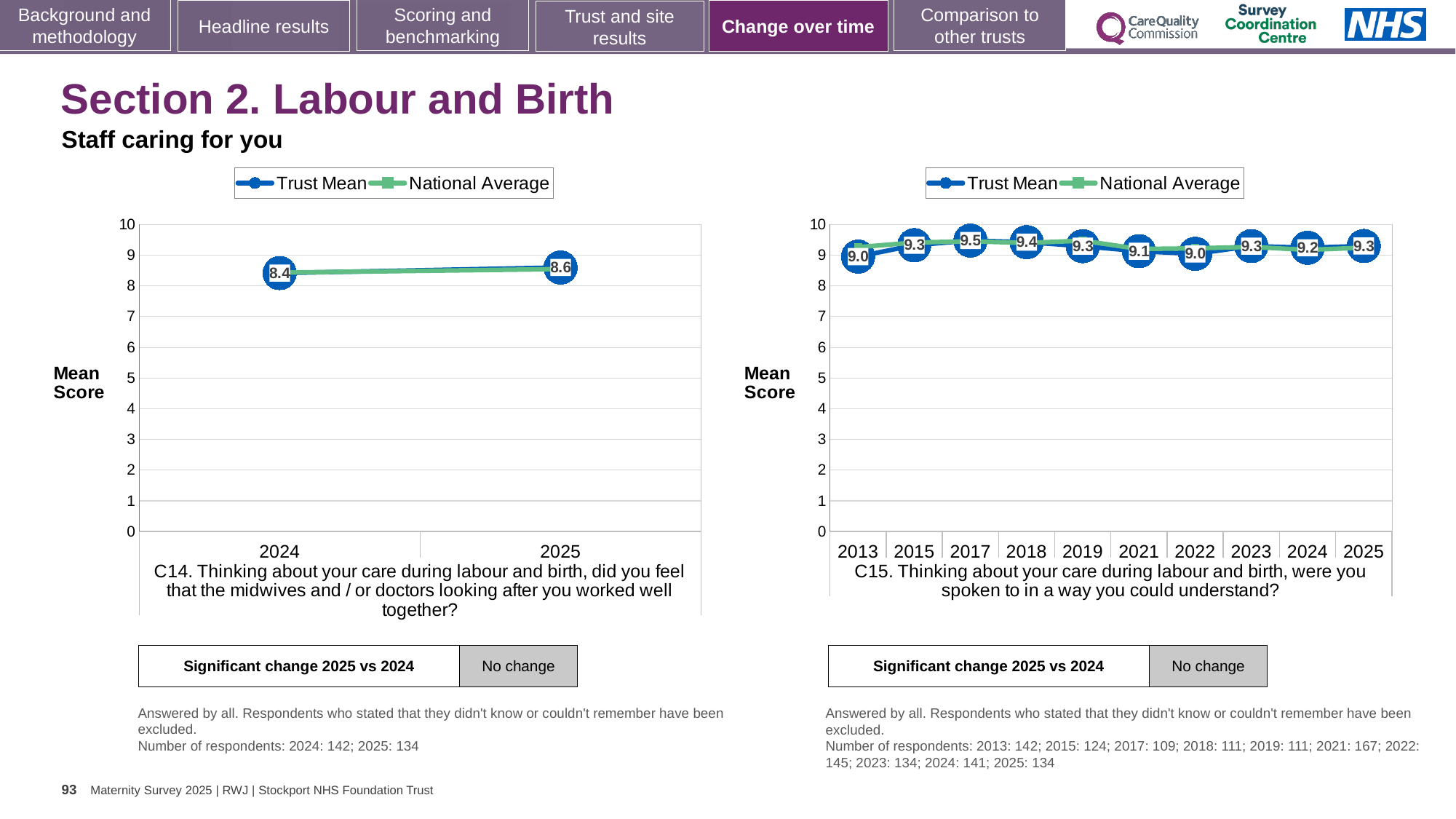
How many years are shown on the x axis of the C15 chart on the right? 10 In the C15 chart on the right, which year has the highest Trust Mean score? 2017 In the C14 chart on the left, what is the Trust Mean score for 2025? 8.6 In the C14 chart on the left, what is the Trust Mean score for 2024? 8.4 In the C15 chart on the right, what is the Trust Mean score for 2017? 9.5 In the C15 chart on the right, what is the lowest Trust Mean score shown? 9.0 In the C15 chart on the right, what is the difference between the Trust Mean in 2017 and in 2013? 0.5 How many series does the legend of the C14 chart on the left list? 2 In the C14 chart on the left, by how much did the Trust Mean change from 2024 to 2025? 0.2 In the C15 chart on the right, what is the Trust Mean score for 2022? 9.0 In the C15 chart on the right, is the Trust Mean higher in 2018 or in 2021? 2018 What type of chart is the C14 chart on the left? Line chart